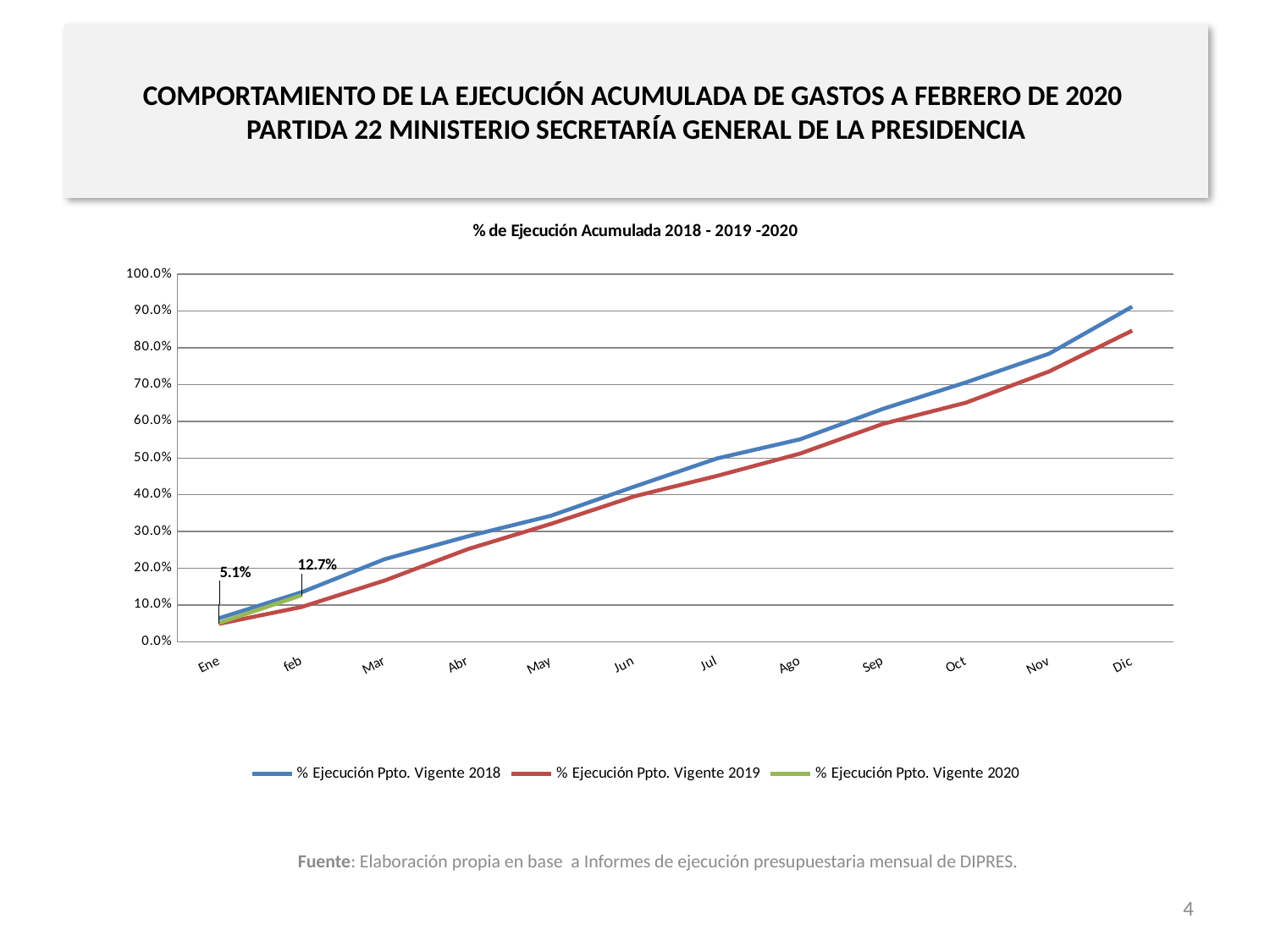
What is the value of % Ejecución Ppto. Vigente 2020 for feb? 12.7% In Dic, which series is higher: % Ejecución Ppto. Vigente 2018 or % Ejecución Ppto. Vigente 2019? % Ejecución Ppto. Vigente 2018 What is the title of the chart? % de Ejecución Acumulada 2018 - 2019 -2020 Is the value for % Ejecución Ppto. Vigente 2019 in Oct greater or less than 60.0%? greater How many series does the legend list? 3 What is the value of % Ejecución Ppto. Vigente 2020 for Ene? 5.1% How many months are shown along the x axis? 12 By how many percentage points did % Ejecución Ppto. Vigente 2020 increase from Ene to feb? 7.6 percentage points Do the values for % Ejecución Ppto. Vigente 2018 rise or fall from Ene to Dic? rise Is the value for % Ejecución Ppto. Vigente 2019 in Dic greater or less than 90.0%? less What kind of chart is shown on the slide? line chart In which month does % Ejecución Ppto. Vigente 2018 reach its highest value? Dic